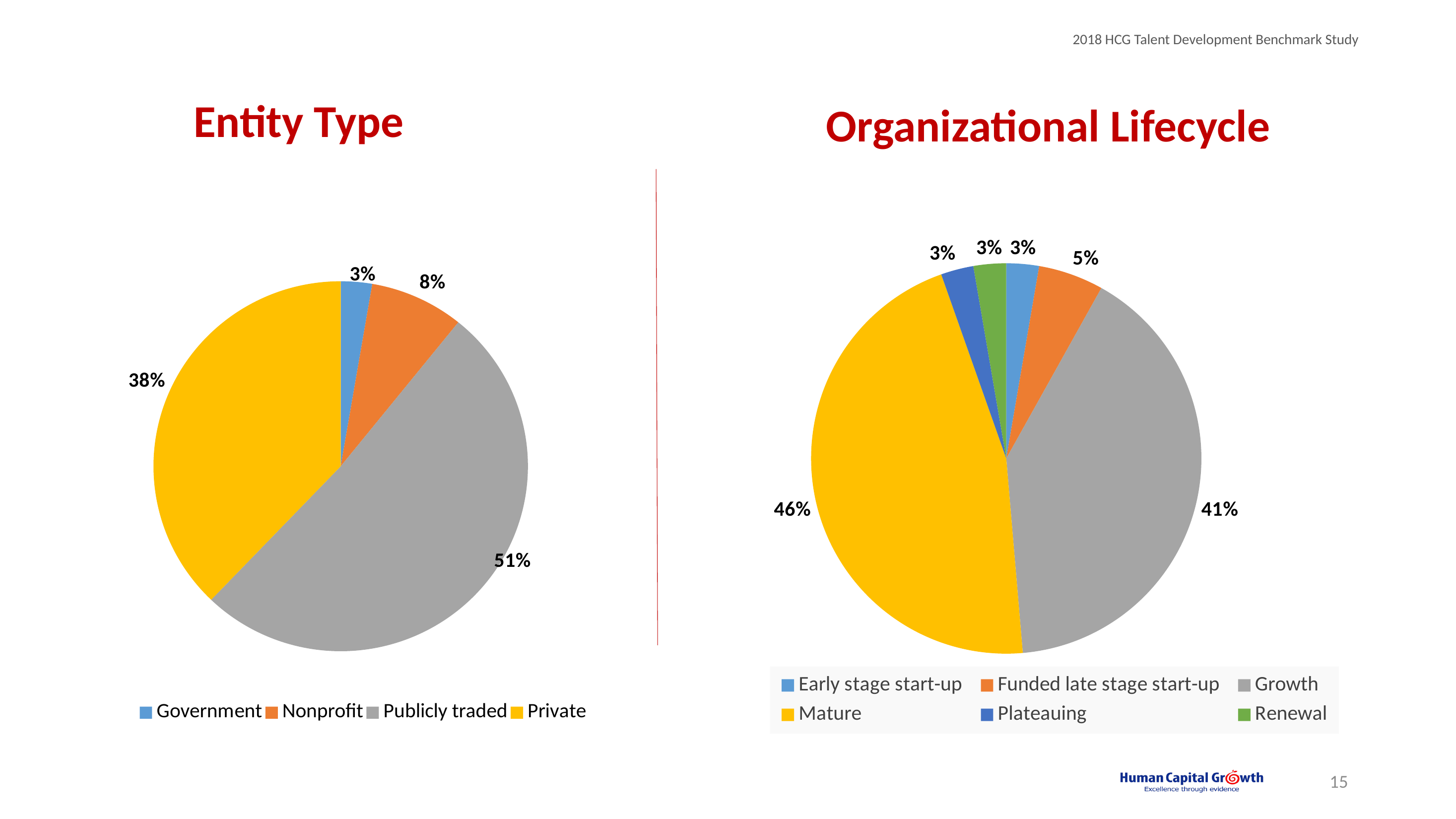
In the Organizational Lifecycle chart, what share is Growth? 41% In the Organizational Lifecycle chart, what share is Funded late stage start-up? 5% In the Organizational Lifecycle chart, what share is Mature? 46% In the Entity Type chart, what share is Publicly traded? 51% In the Entity Type chart, how many categories are shown? 4 In the Organizational Lifecycle chart, which category has the largest share? Mature In the Entity Type chart, what is the difference between the Publicly traded and Private shares? 13% What type of chart is used for Organizational Lifecycle? Pie chart In the Entity Type chart, what share is Nonprofit? 8% In the Entity Type chart, what share is Private? 38% In the Entity Type chart, which category has the smallest share? Government In the Organizational Lifecycle chart, how many categories does the legend list? 6